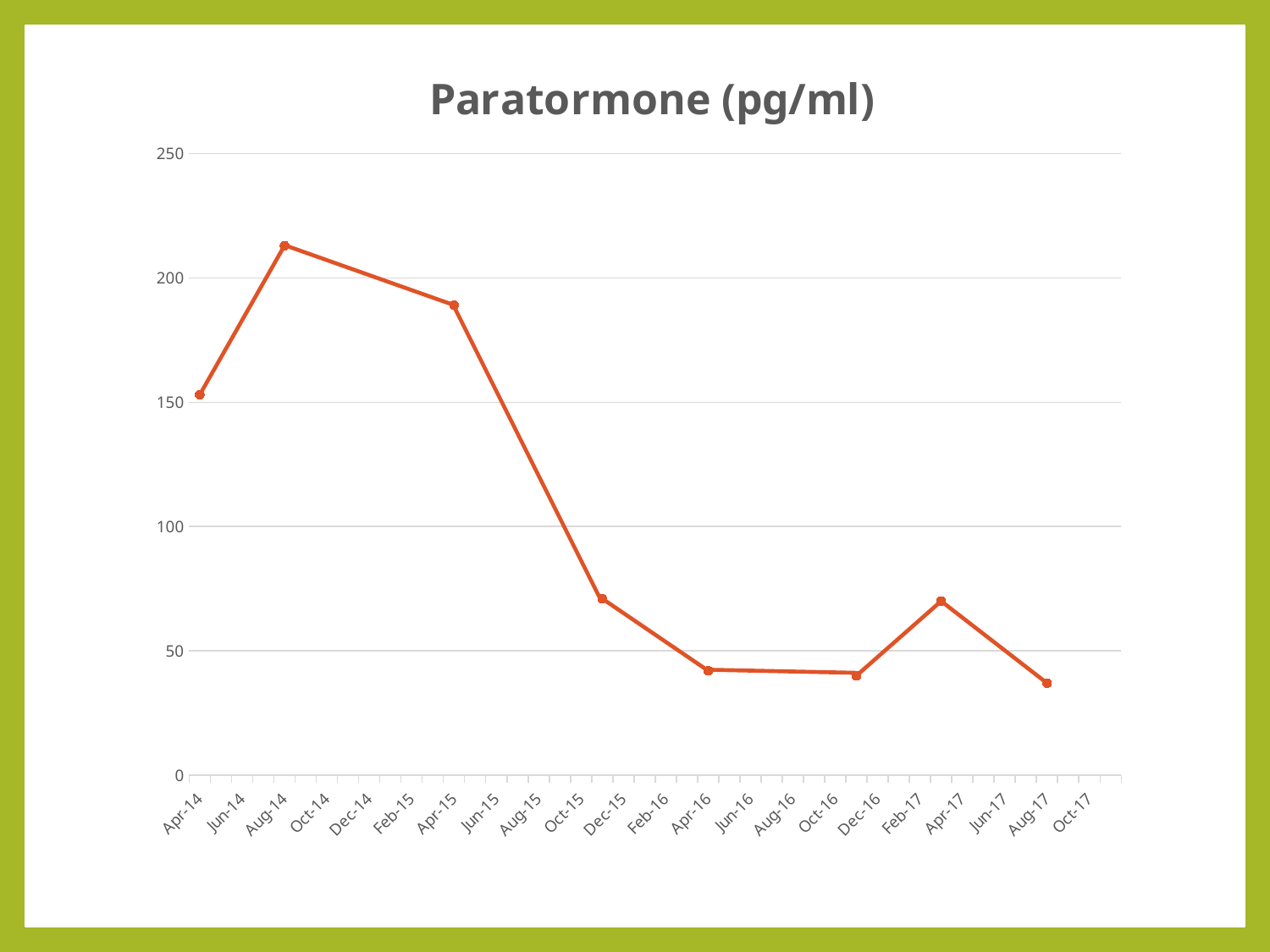
Is the value for Aug-14 greater or less than 200? greater Which is larger, the value for Aug-14 or the value for Apr-15? Aug-14 Is the value for Apr-14 greater or less than 100? greater What is the title of the chart? Paratormone (pg/ml) Is the value for Apr-16 greater or less than 50? less Overall, do the Paratormone values rise or fall from Apr-14 to Aug-17? fall At which date does the Paratormone value reach its highest point? Aug-14 How many data points are plotted on the line? 8 What kind of chart is shown on the slide? line chart